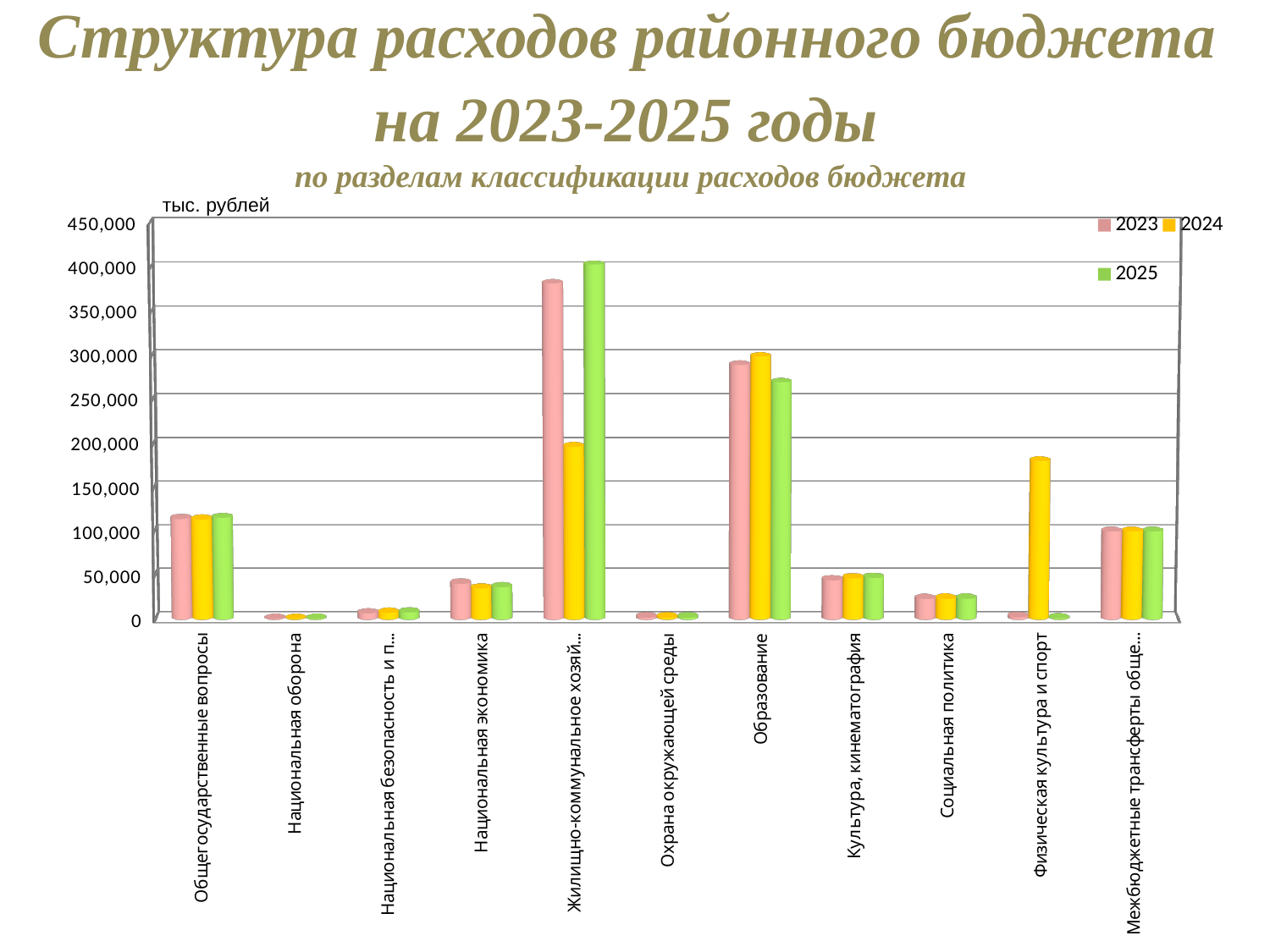
What unit is shown above the vertical axis? тыс. рублей Is the 2023 value for Национальная экономика greater or less than 50,000? less For Физическая культура и спорт, which year has the larger value, 2024 or 2025? 2024 What kind of chart is shown on the slide? bar chart Which category has the tallest bar for 2025? Жилищно-коммунальное хозяйство How many series does the legend list? 3 Is the 2023 value for Жилищно-коммунальное хозяйство greater or less than 350,000? greater How many categories are shown along the x axis? 11 Which category has the tallest bar for 2024? Образование Which years are listed in the legend? 2023, 2024, 2025 For 2023, which is larger: Образование or Жилищно-коммунальное хозяйство? Жилищно-коммунальное хозяйство Is the 2024 value for Физическая культура и спорт greater or less than 150,000? greater